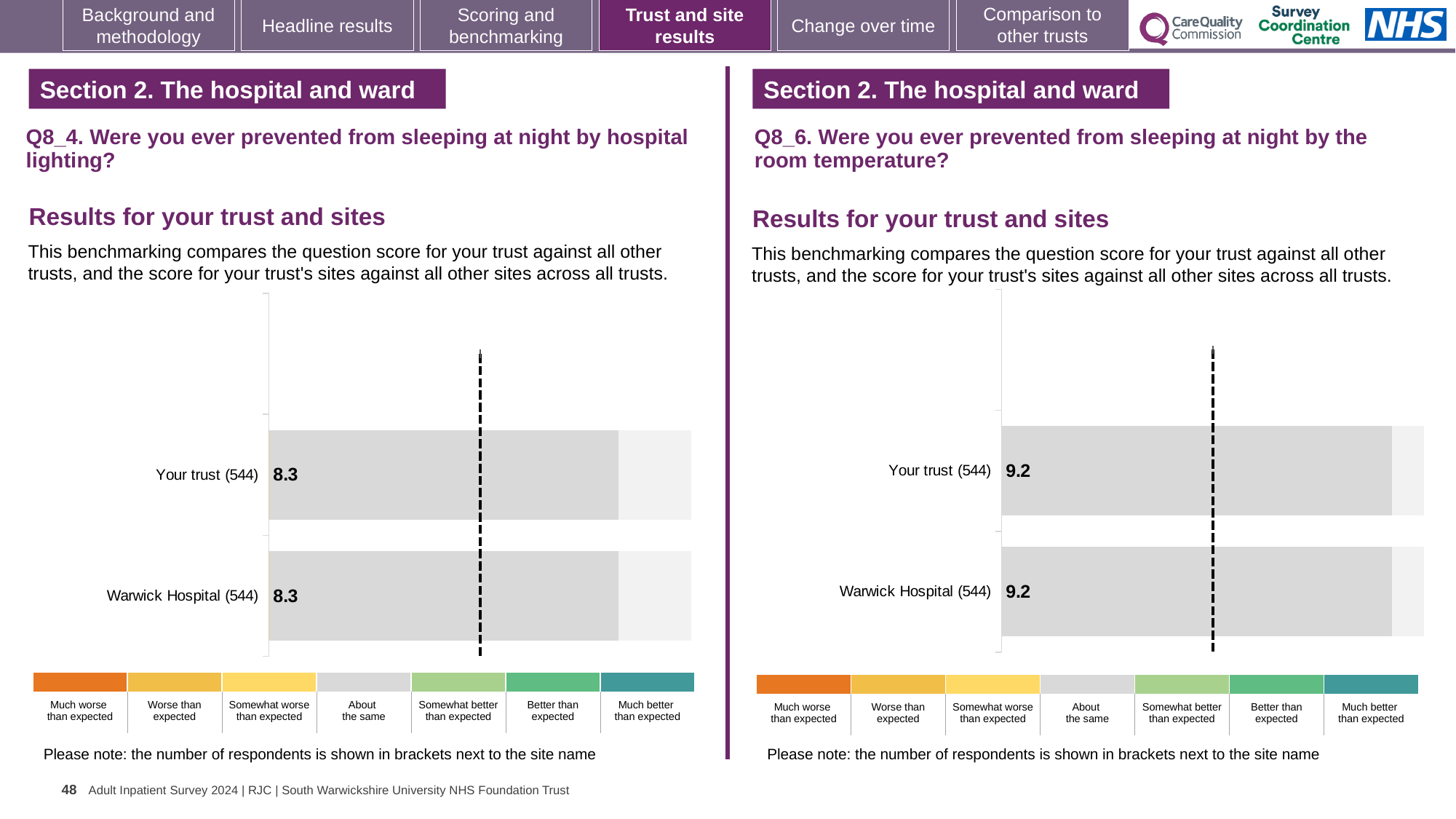
On the right chart (Q8_6, room temperature), what is the difference between the Your trust score and the Warwick Hospital score? 0.0 How many bars are plotted on the right chart (Q8_6, room temperature)? 2 On the right chart (Q8_6, room temperature), which benchmark category does the grey colour of the Your trust bar correspond to in the key? About the same On the right chart (Q8_6, room temperature), what is the score for Warwick Hospital? 9.2 On the left chart (Q8_4, hospital lighting), what is the difference between the Your trust score and the Warwick Hospital score? 0.0 How many respondents are shown in brackets for Warwick Hospital on the right chart (Q8_6, room temperature)? 544 What kind of chart is used on the left (Q8_4, hospital lighting)? Bar chart On the left chart (Q8_4, hospital lighting), what is the score for Your trust? 8.3 How many bars are plotted on the left chart (Q8_4, hospital lighting)? 2 On the left chart (Q8_4, hospital lighting), what is the score for Warwick Hospital? 8.3 How many benchmark categories does the colour key below the left chart (Q8_4, hospital lighting) list? 7 On the right chart (Q8_6, room temperature), what is the score for Your trust? 9.2